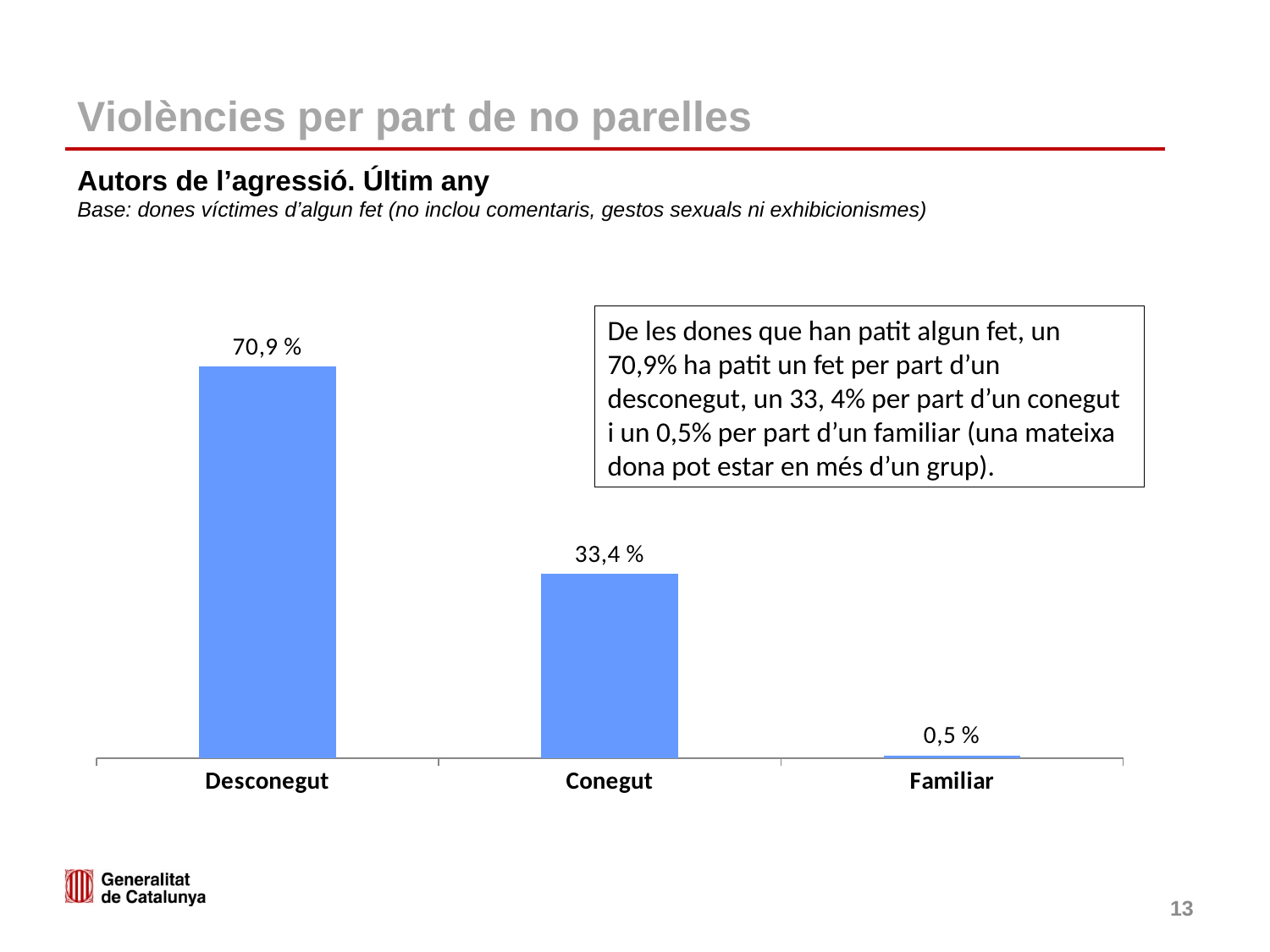
What is the difference between the values for Desconegut and Conegut? 37,5 % Which category has the lowest value? Familiar What is the title of the chart? Autors de l'agressió. Últim any What kind of chart is shown on the slide? Bar chart How many categories are shown on the x axis? 3 What is the value for Desconegut? 70,9 % Which is larger, the value for Conegut or the value for Familiar? Conegut What is the value for Familiar? 0,5 % Do the values rise or fall from left to right along the x axis? Fall Which category has the highest value? Desconegut What is the difference between the values for Conegut and Familiar? 32,9 % What is the value for Conegut? 33,4 %